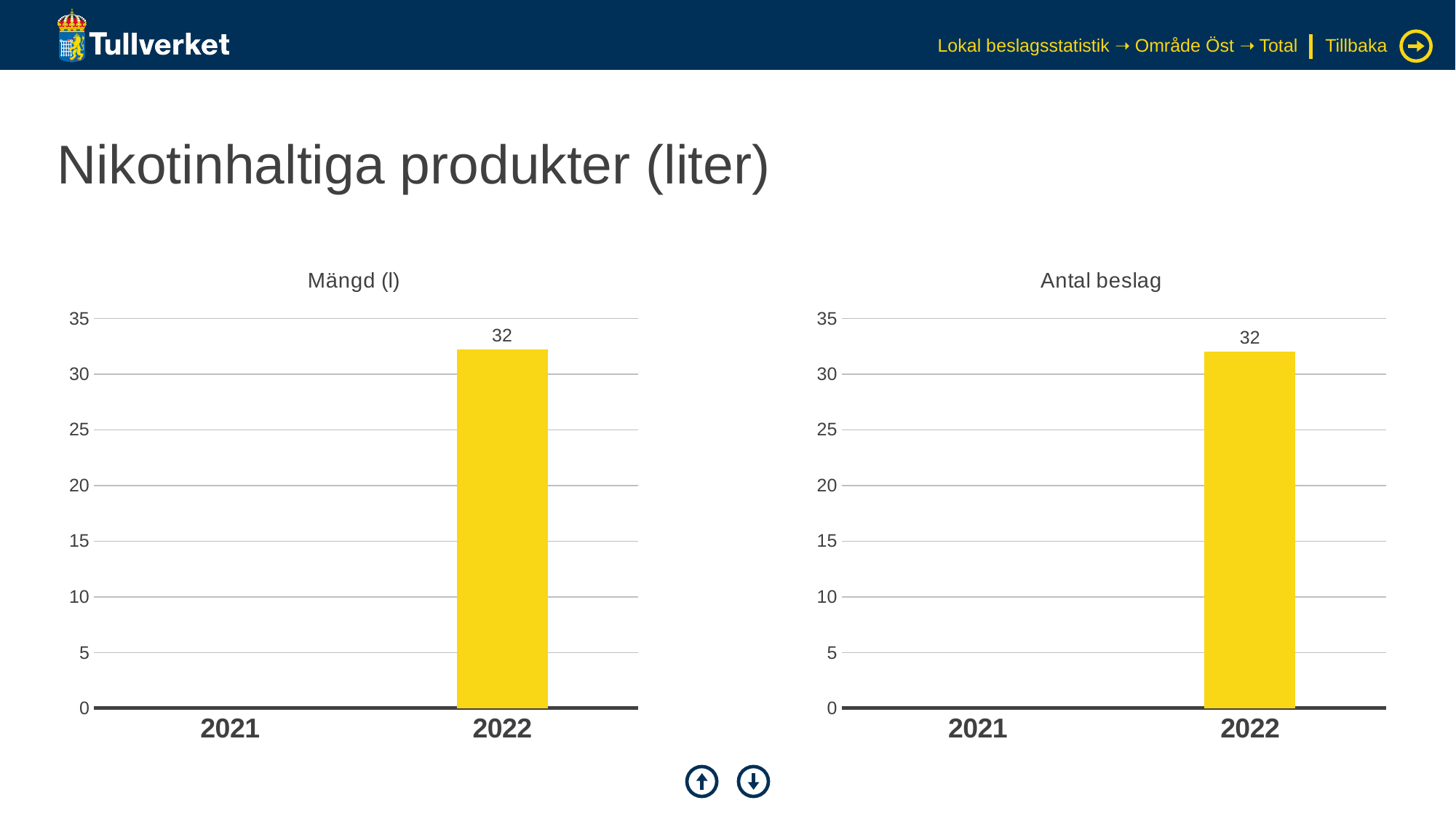
In the 'Mängd (l)' chart, which year has the larger value, 2021 or 2022? 2022 In the 'Antal beslag' chart, what is the value for 2022? 32 In the 'Antal beslag' chart, do the values rise or fall from 2021 to 2022? rise In the 'Mängd (l)' chart, which year has the highest value? 2022 In the 'Mängd (l)' chart, how many years are shown on the x axis? 2 In the 'Antal beslag' chart, is the value for 2022 greater or less than 35? less In the 'Mängd (l)' chart, is the value for 2022 greater or less than 30? greater In the 'Mängd (l)' chart, what is the value for 2022? 32 What kind of chart is the 'Antal beslag' chart? bar chart In the 'Antal beslag' chart, which year has the lowest value? 2021 What is the title of the chart on the left side of the slide? Mängd (l) What colour are the bars in the 'Antal beslag' chart? yellow